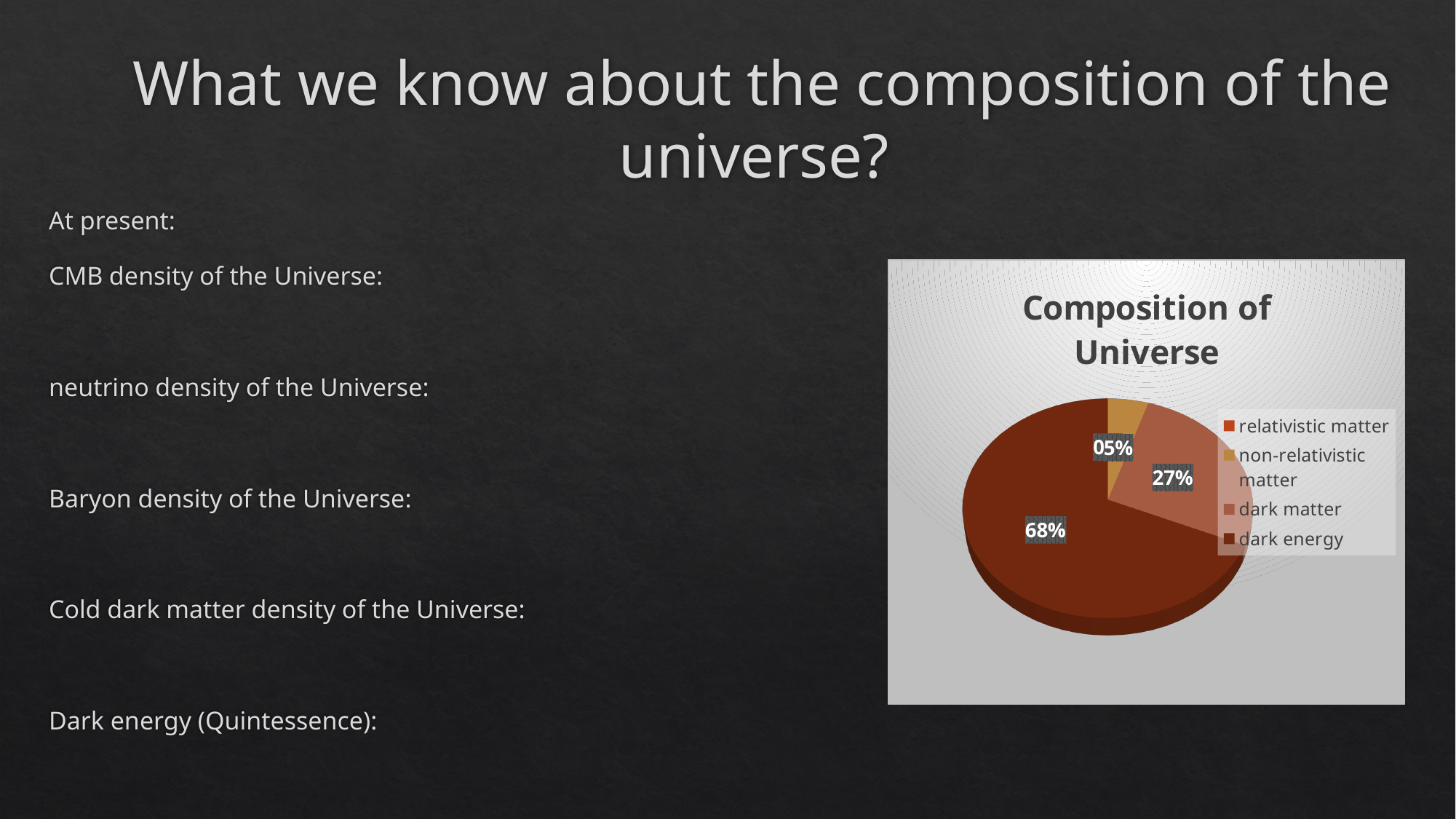
How many slices carry a percentage label? 3 What is the title of the chart? Composition of Universe How many entries does the chart's legend list? 4 Which category has the largest slice of the pie? dark energy Which of the labelled slices is the smallest? non-relativistic matter Which is larger, the dark matter slice or the non-relativistic matter slice? dark matter Which legend entry is listed first? relativistic matter What percentage of the pie is dark energy? 68% What is the difference in percentage points between dark energy and dark matter? 41 What kind of chart is shown on the slide? pie chart What percentage of the pie is dark matter? 27% What percentage of the pie is non-relativistic matter? 05%